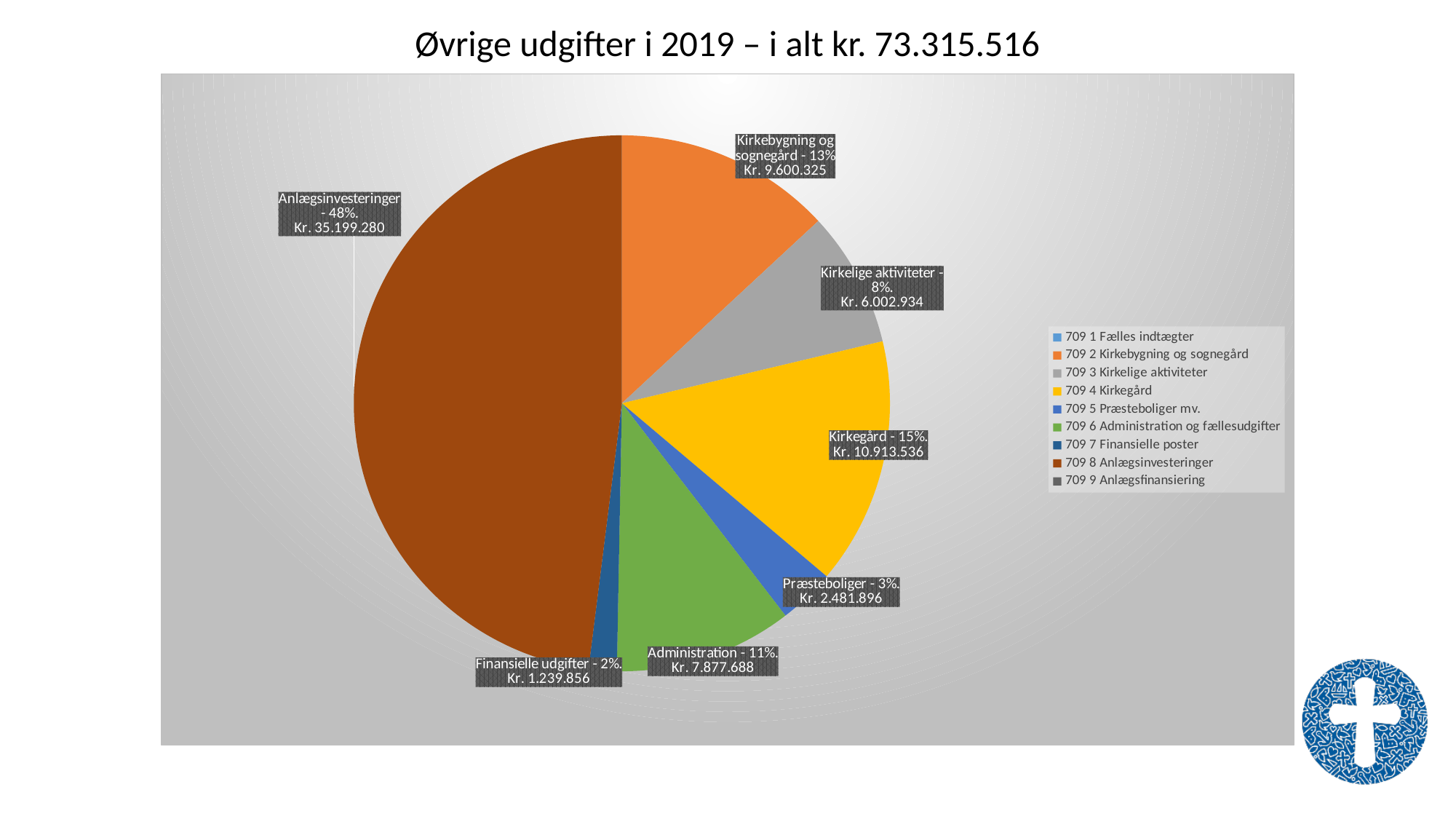
How many entries does the legend list? 9 What percentage share of the pie does Administration have? 11% What is the title of the chart? Øvrige udgifter i 2019 – i alt kr. 73.315.516 Which labelled category has the smallest slice of the pie? Finansielle udgifter Which is larger, Kirkegård or Kirkelige aktiviteter? Kirkegård Which category has the largest slice of the pie? Anlægsinvesteringer What is the value shown for Finansielle udgifter? Kr. 1.239.856 What is the value shown for Anlægsinvesteringer? Kr. 35.199.280 What is the difference in percentage share between Kirkegård and Præsteboliger? 12% What kind of chart is shown on the slide? pie chart What is the value shown for Kirkegård? Kr. 10.913.536 What percentage share of the pie does Kirkebygning og sognegård have? 13%